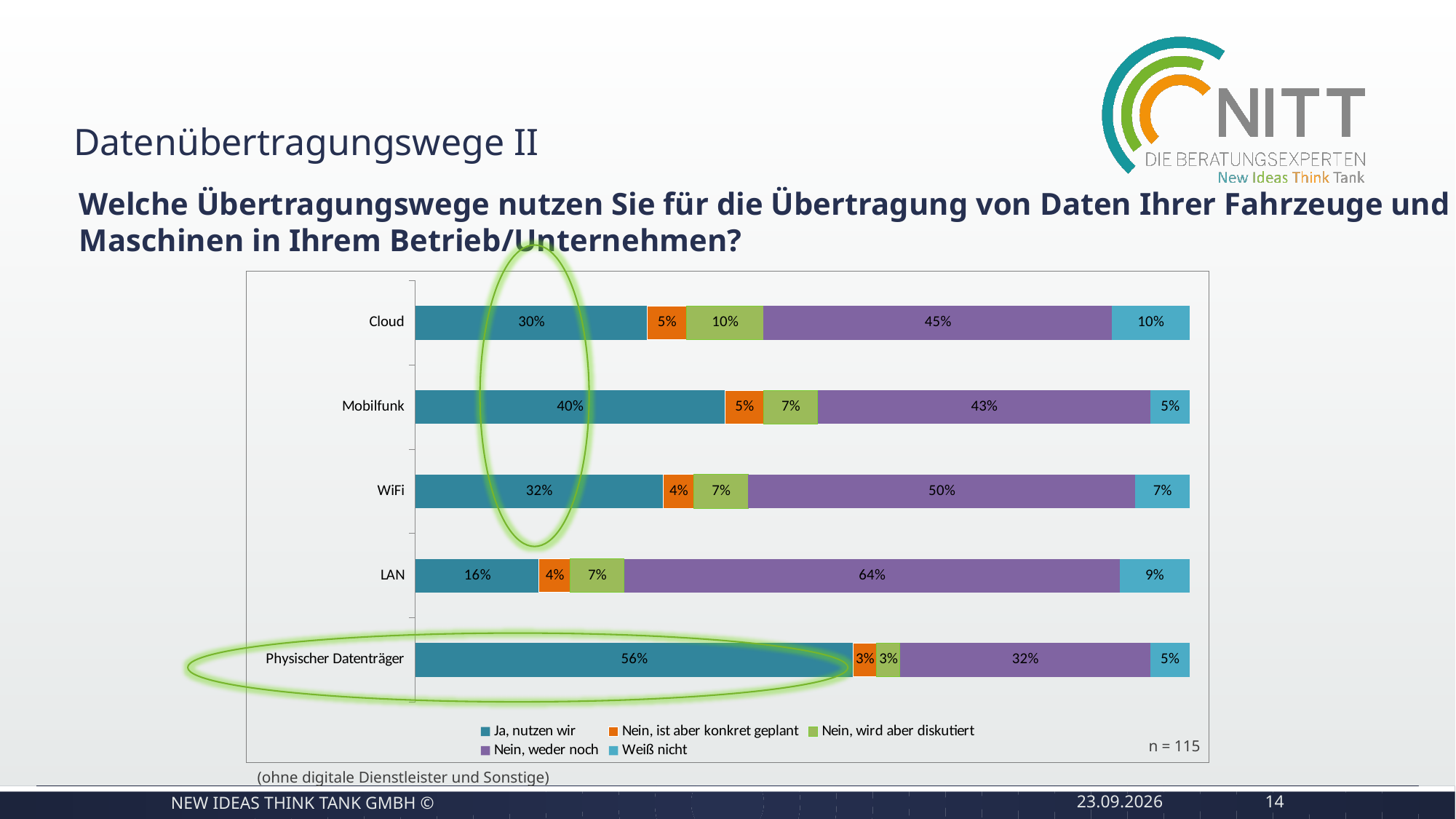
What is the difference between the "Nein, weder noch" values for LAN and Physischer Datenträger? 32% What type of chart is shown on the slide? Stacked bar chart Which is larger: the "Ja, nutzen wir" value for Mobilfunk or for WiFi? Mobilfunk What is the total of the stacked bar for WiFi? 100% Which category has the lowest "Ja, nutzen wir" share? LAN Which category has the highest "Ja, nutzen wir" share? Physischer Datenträger How many categories (transmission methods) are shown in the chart? 5 What is the "Nein, weder noch" value for LAN? 64% How many series does the legend list? 5 What percentage of respondents answered "Ja, nutzen wir" for Cloud? 30% What sample size (n) is stated on the chart? n = 115 What is the "Weiß nicht" value for Mobilfunk? 5%